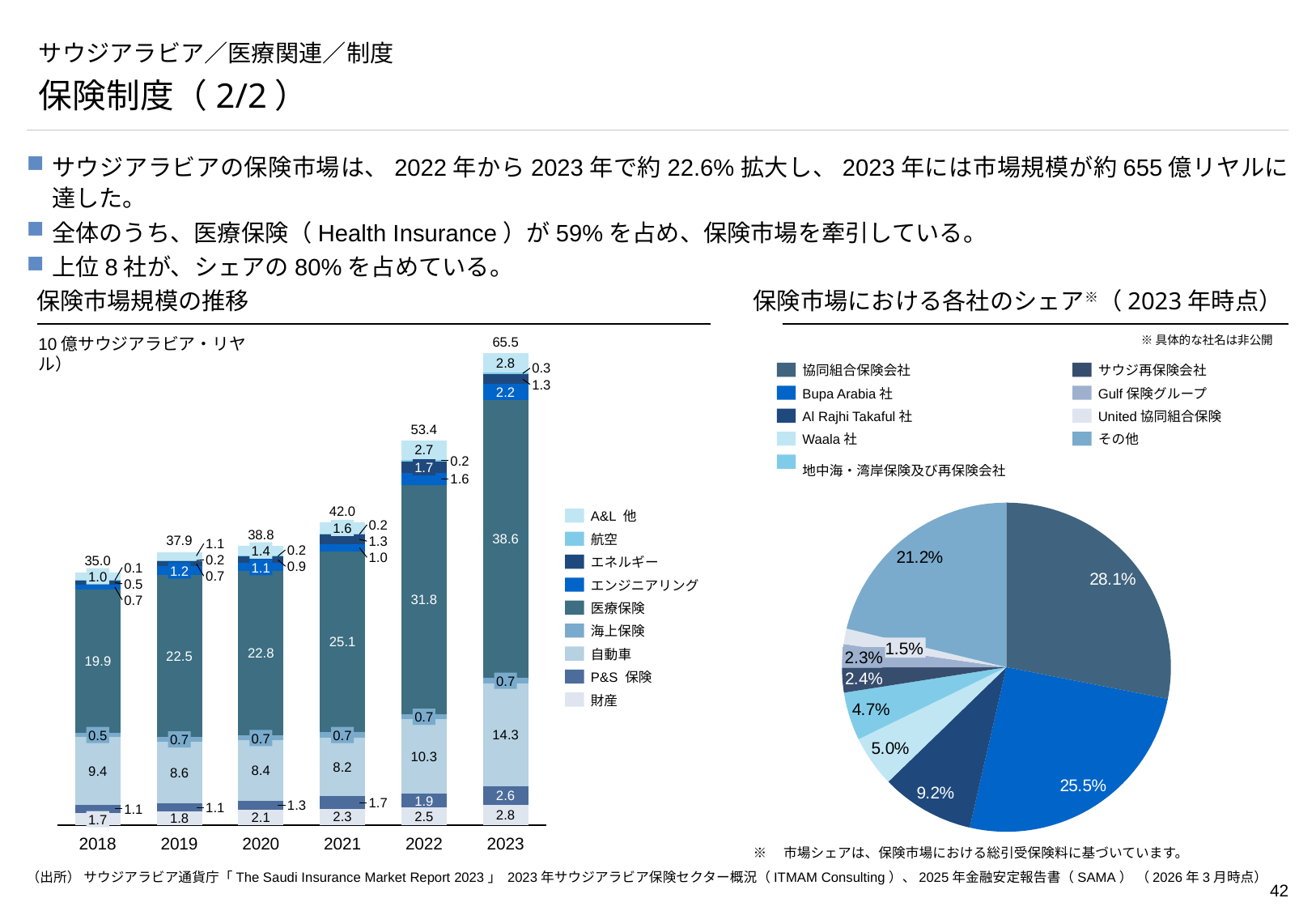
In the right chart (保険市場における各社のシェア), what share does Bupa Arabia 社 hold? 25.5% In the left chart (保険市場規模の推移), how many years are shown on the x axis? 6 In the left chart (保険市場規模の推移), what is the value of 医療保険 for 2023? 38.6 In the left chart (保険市場規模の推移), do the totals rise or fall from 2018 to 2023? rise What kind of chart is the right chart (保険市場における各社のシェア)? pie chart In the left chart (保険市場規模の推移), which year has the lowest total? 2018 In the left chart (保険市場規模の推移), what is the difference between the 2023 total and the 2022 total? 12.1 In the left chart (保険市場規模の推移), what is the total insurance market size shown for 2023? 65.5 In the left chart (保険市場規模の推移), what is the value of 自動車 for 2022? 10.3 In the left chart (保険市場規模の推移), is the 医療保険 value larger in 2021 or in 2020? 2021 In the left chart (保険市場規模の推移), how many series does the legend list? 9 In the left chart (保険市場規模の推移), which year has the highest total? 2023